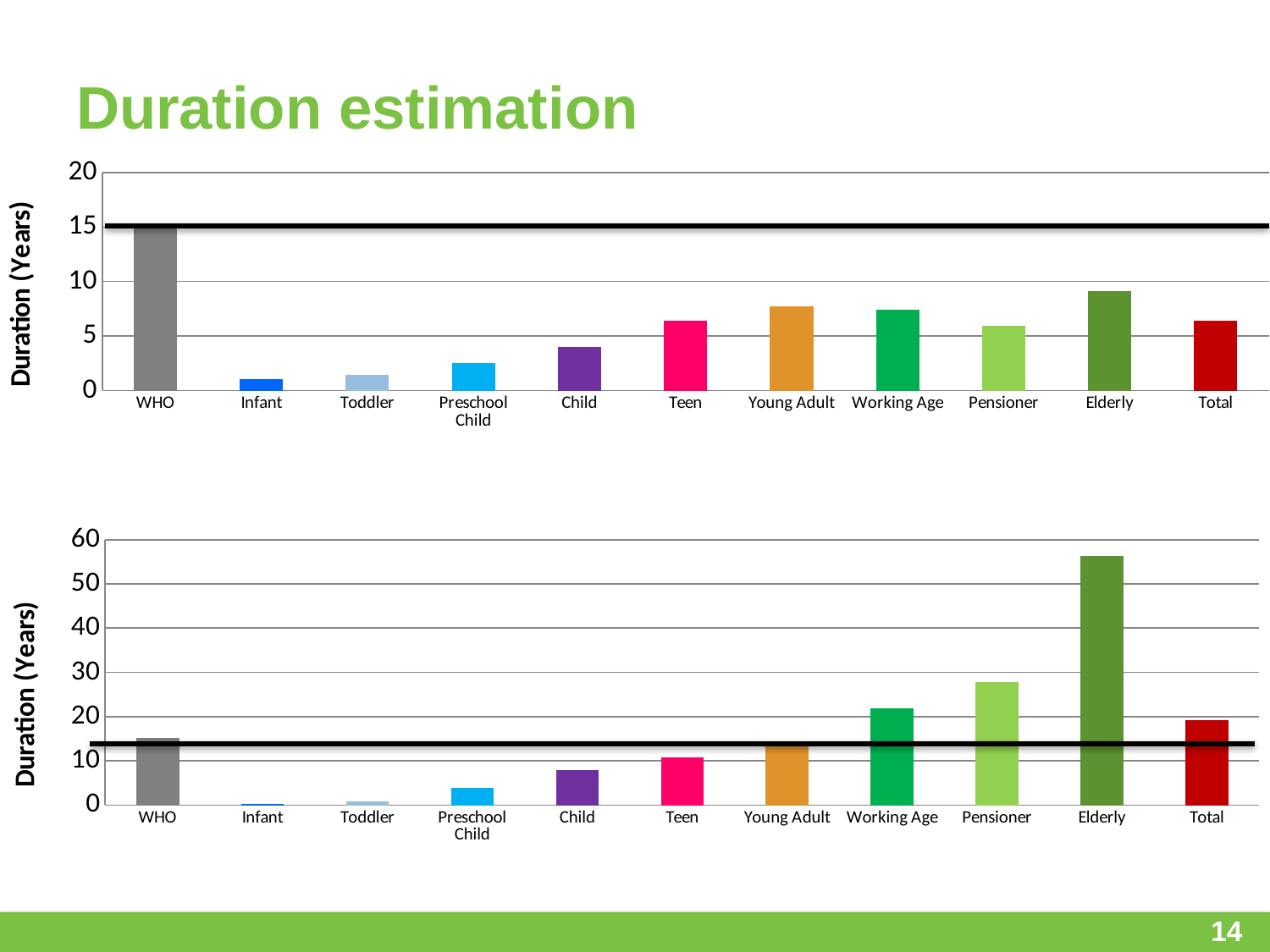
What kind of chart is the bottom chart? bar chart How many categories are shown on the x axis of the top chart? 11 In the top chart, which category has the highest bar? WHO In the bottom chart, which is larger, the value for Pensioner or the value for Working Age? Pensioner In the bottom chart, which category has the highest bar? Elderly In the bottom chart, is the value for Pensioner greater or less than 20? greater In the bottom chart, which category has the lowest bar? Infant In the top chart, is the value for Elderly greater or less than 10? less In the bottom chart, is the value for Elderly greater or less than 50? greater What is the y-axis label of the top chart? Duration (Years) In the top chart, which category has the lowest bar? Infant